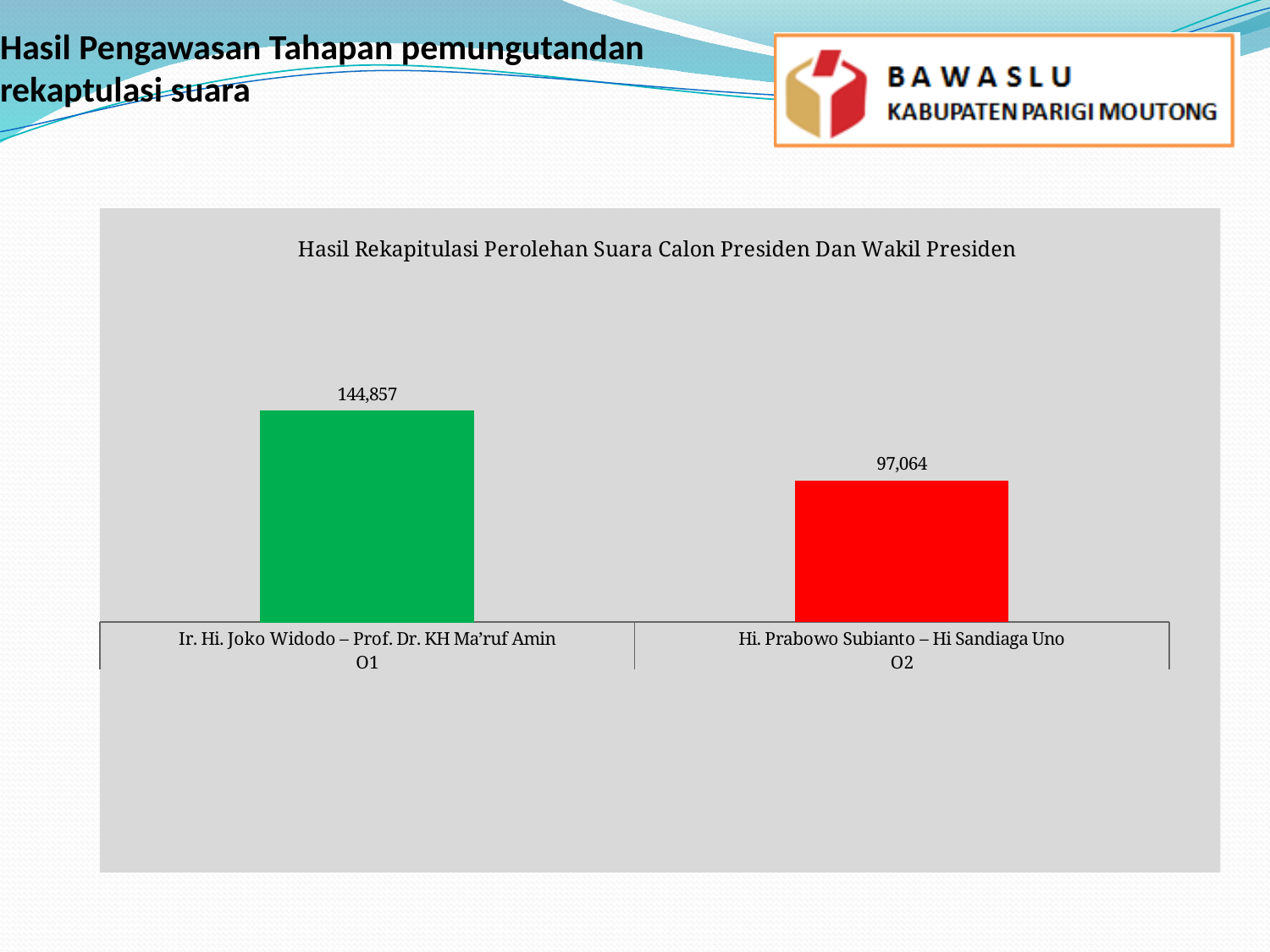
Which candidate pair has the highest vote count? Ir. Hi. Joko Widodo – Prof. Dr. KH Ma'ruf Amin Which candidate pair has the lowest vote count? Hi. Prabowo Subianto – Hi Sandiaga Uno What is the difference between the votes for pair 01 and pair 02? 47,793 What is the value for Hi. Prabowo Subianto – Hi Sandiaga Uno (02)? 97,064 What is the title of the chart? Hasil Rekapitulasi Perolehan Suara Calon Presiden Dan Wakil Presiden How many candidate pairs are shown in the chart? 2 Which is larger, the value for pair 01 or the value for pair 02? Pair 01 What kind of chart is shown on the slide? Bar chart What colour is the bar for Hi. Prabowo Subianto – Hi Sandiaga Uno? Red What is the value for Ir. Hi. Joko Widodo – Prof. Dr. KH Ma'ruf Amin (01)? 144,857 What is the total of the two vote counts shown in the chart? 241,921